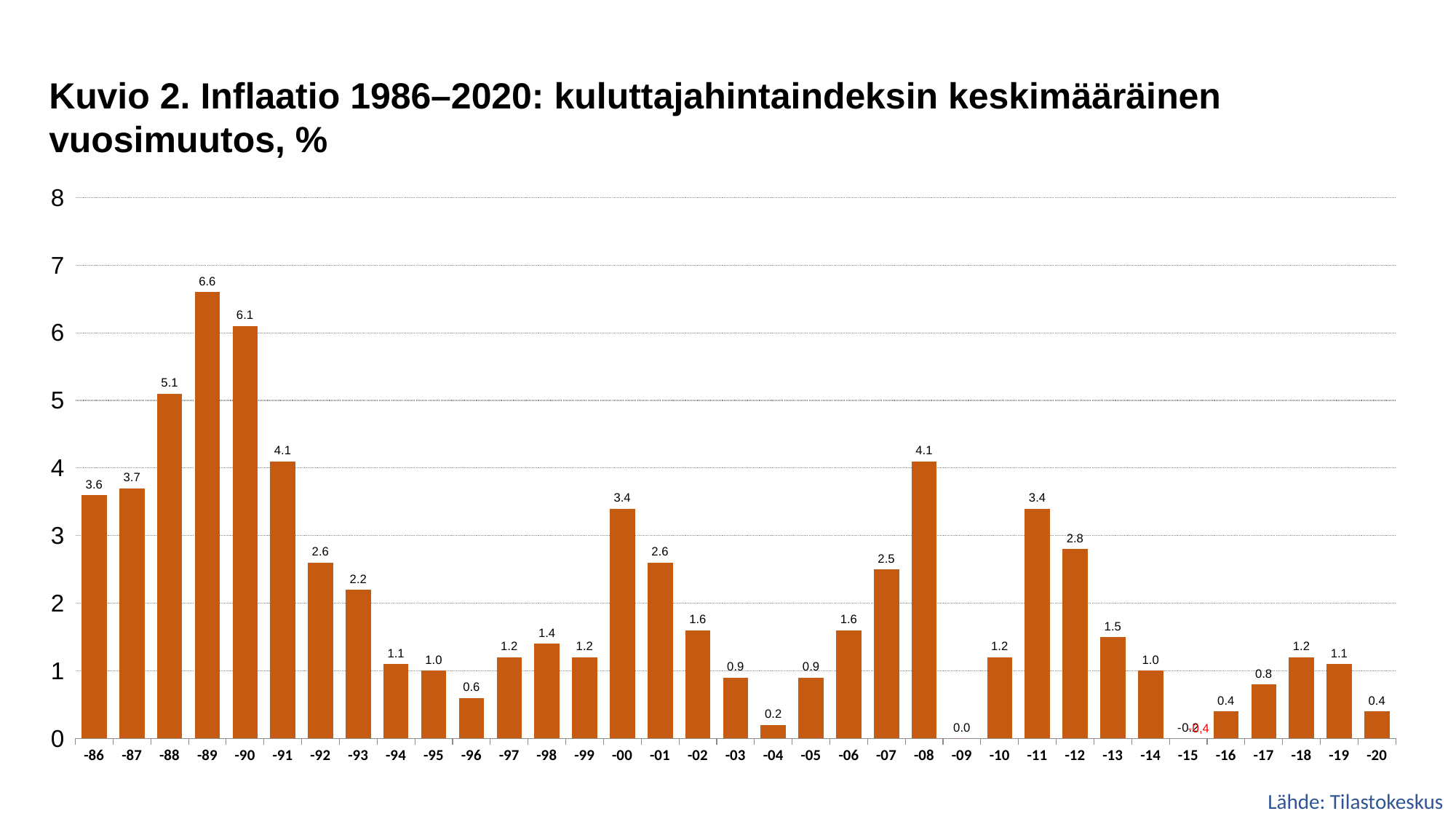
How many years (bars) are shown on the x axis? 35 What kind of chart is shown on the slide? bar chart Which is larger, the value for -00 or the value for -01? -00 What is the inflation value for -89? 6.6 What is the difference between the values for -89 and -90? 0.5 What is the source cited at the bottom of the slide? Tilastokeskus What is the inflation value for -08? 4.1 Which year has the highest inflation value? -89 What is the inflation value for -20? 0.4 What is the difference between the values for -11 and -12? 0.6 Is the value for -88 greater or less than 5? greater What is the inflation value for -09? 0.0